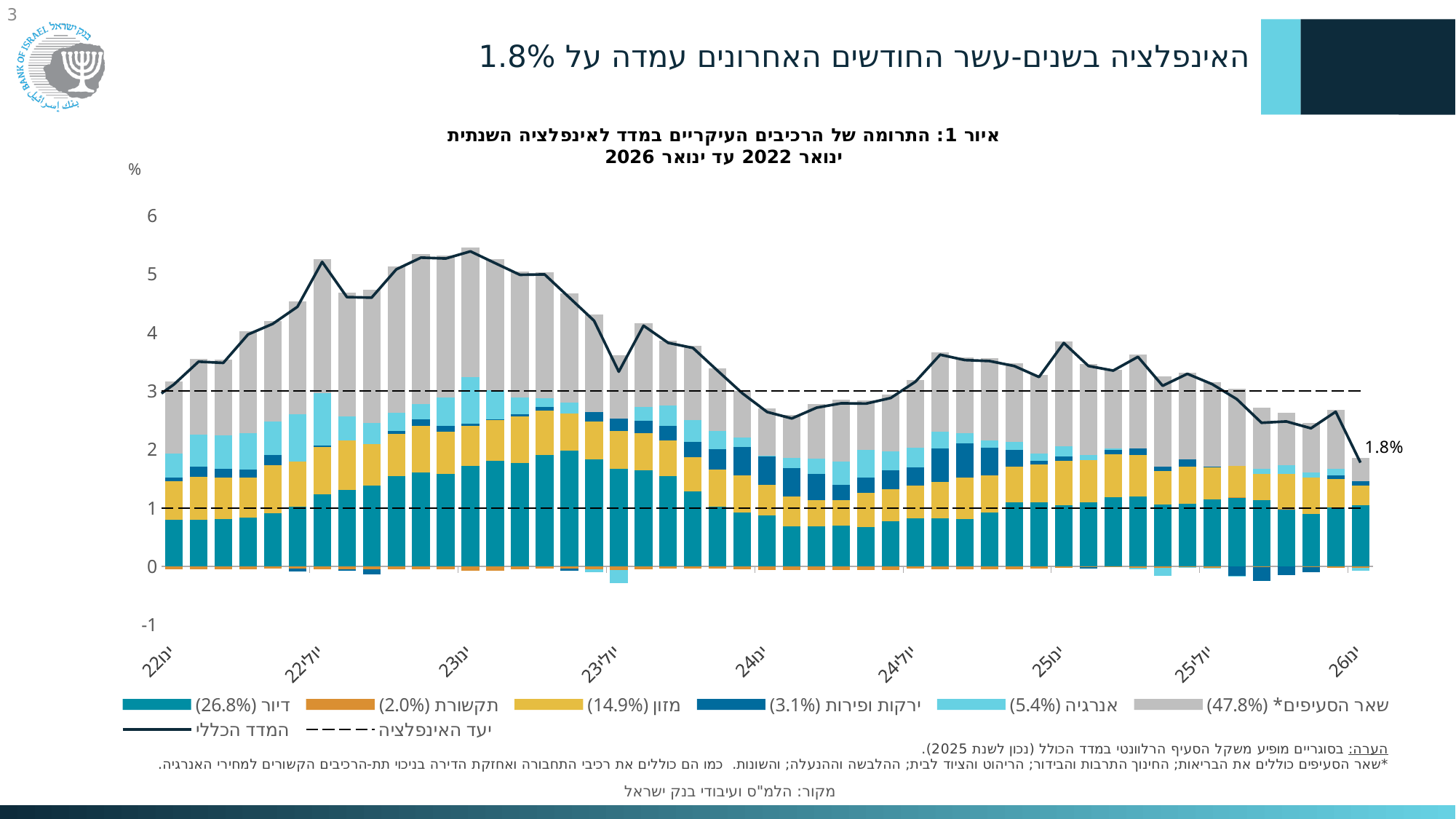
What does the dashed horizontal line represent, according to the legend? יעד האינפלציה What type of chart is shown on the slide? stacked bar chart with a line How many entries does the legend list? 8 Which is higher on the overall index line: January 2023 (ינו'23) or January 2024 (ינו'24)? January 2023 (ינו'23) How many labelled tick marks are there on the x axis? 9 What is the value of the overall index (המדד הכללי) at the last point, January 2026 (ינו'26)? 1.8% Is the value of the overall index line at January 2023 (ינו'23) greater or less than 5? greater Is the value of the overall index line at January 2024 (ינו'24) greater or less than 3? less According to the legend, what weight is shown for housing (דיור)? 26.8% Is the value of the overall index line at July 2022 (יולי'22) greater or less than 4? greater Does the overall index line rise or fall between July 2025 (יולי'25) and January 2026 (ינו'26)? fall